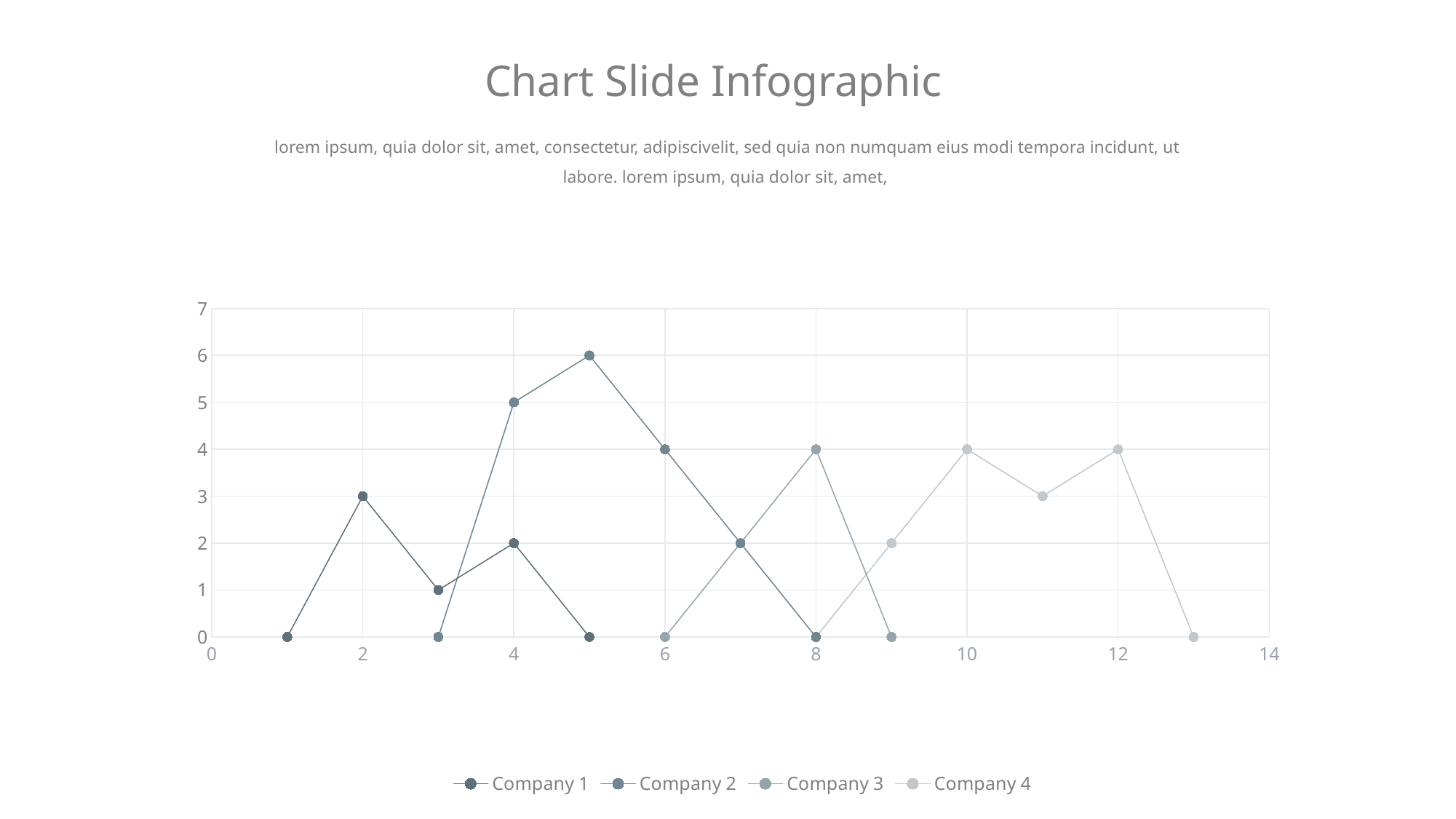
Does Company 2 rise or fall between x = 5 and x = 8? fall What is the value of Company 1 at x = 2? 3 How many series does the legend list? 4 What is the value of Company 2 at x = 4? 5 What is the highest value reached by Company 2? 6 What is the value of Company 4 at x = 12? 4 What is the difference between Company 2 and Company 1 at x = 4? 3 At x = 6, which is larger, Company 2 or Company 3? Company 2 What is the value of Company 3 at x = 8? 4 How many data points are plotted for Company 4? 6 What type of chart is shown on the slide? line chart Which series reaches the highest point on the chart? Company 2